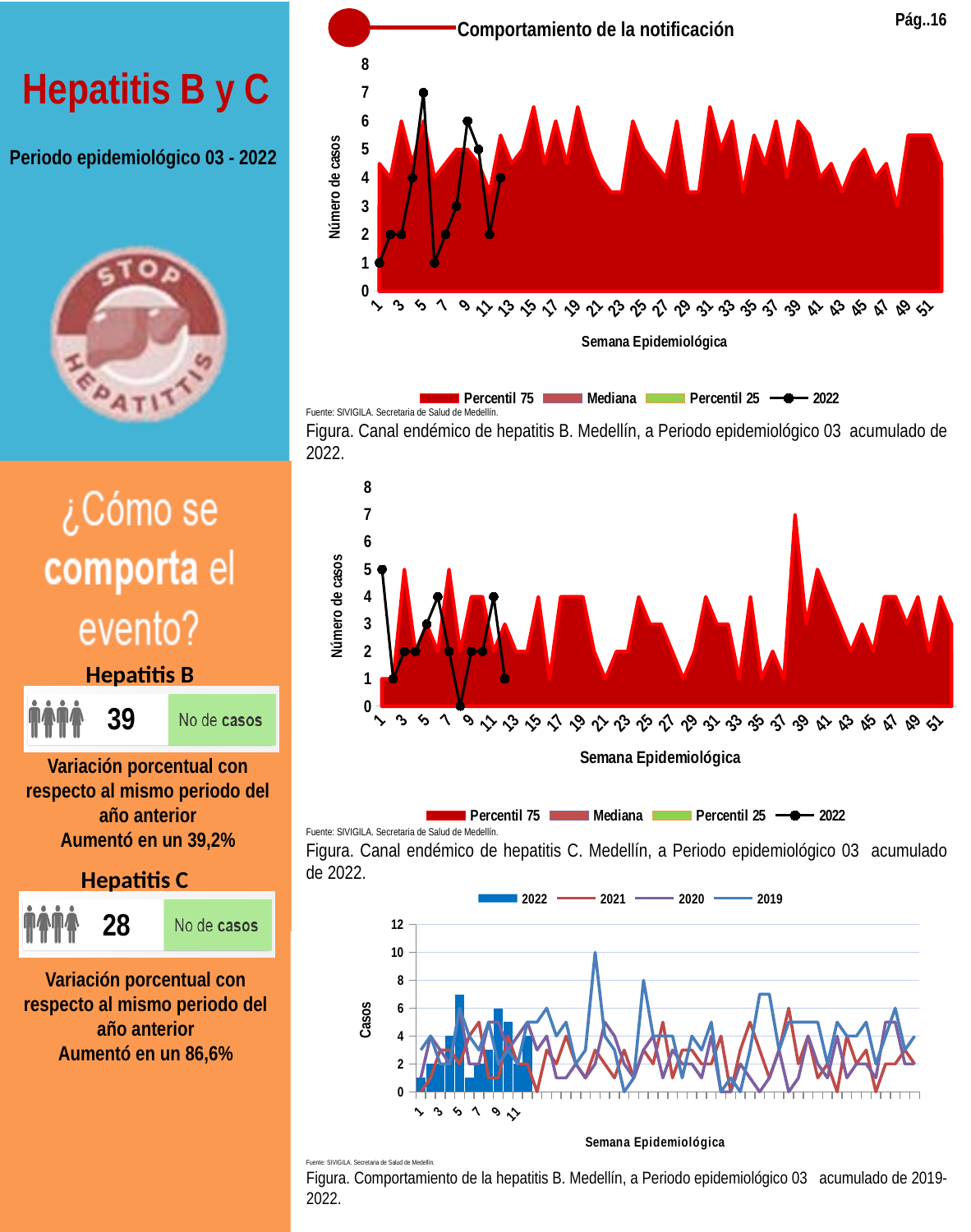
In the top chart (Canal endémico de hepatitis B), at which week does the 2022 line reach its highest value? Week 5 In the top chart (Canal endémico de hepatitis B), how many weeks have a plotted 2022 point? 12 In the bottom chart (Comportamiento de la hepatitis B 2019-2022), how many series does the legend list? 4 In the top chart (Canal endémico de hepatitis B), what is the value of the 2022 line at week 5? 7 In the top chart (Canal endémico de hepatitis B), how many series does the legend list? 4 In the middle chart (Canal endémico de hepatitis C), what is the difference between the 2022 values at week 1 and week 2? 4 In the bottom chart (Comportamiento de la hepatitis B 2019-2022), is the highest value of the 2019 line greater or less than 8? greater What is the x-axis title of the top chart (Canal endémico de hepatitis B)? Semana Epidemiológica In the top chart (Canal endémico de hepatitis B), is the 2022 value at week 5 larger or the value at week 6? Week 5 In the middle chart (Canal endémico de hepatitis C), at which week does the 2022 line reach its highest value? Week 1 In the middle chart (Canal endémico de hepatitis C), what is the value of the 2022 line at week 8? 0 In the middle chart (Canal endémico de hepatitis C), at which week does the 2022 line reach its lowest value? Week 8